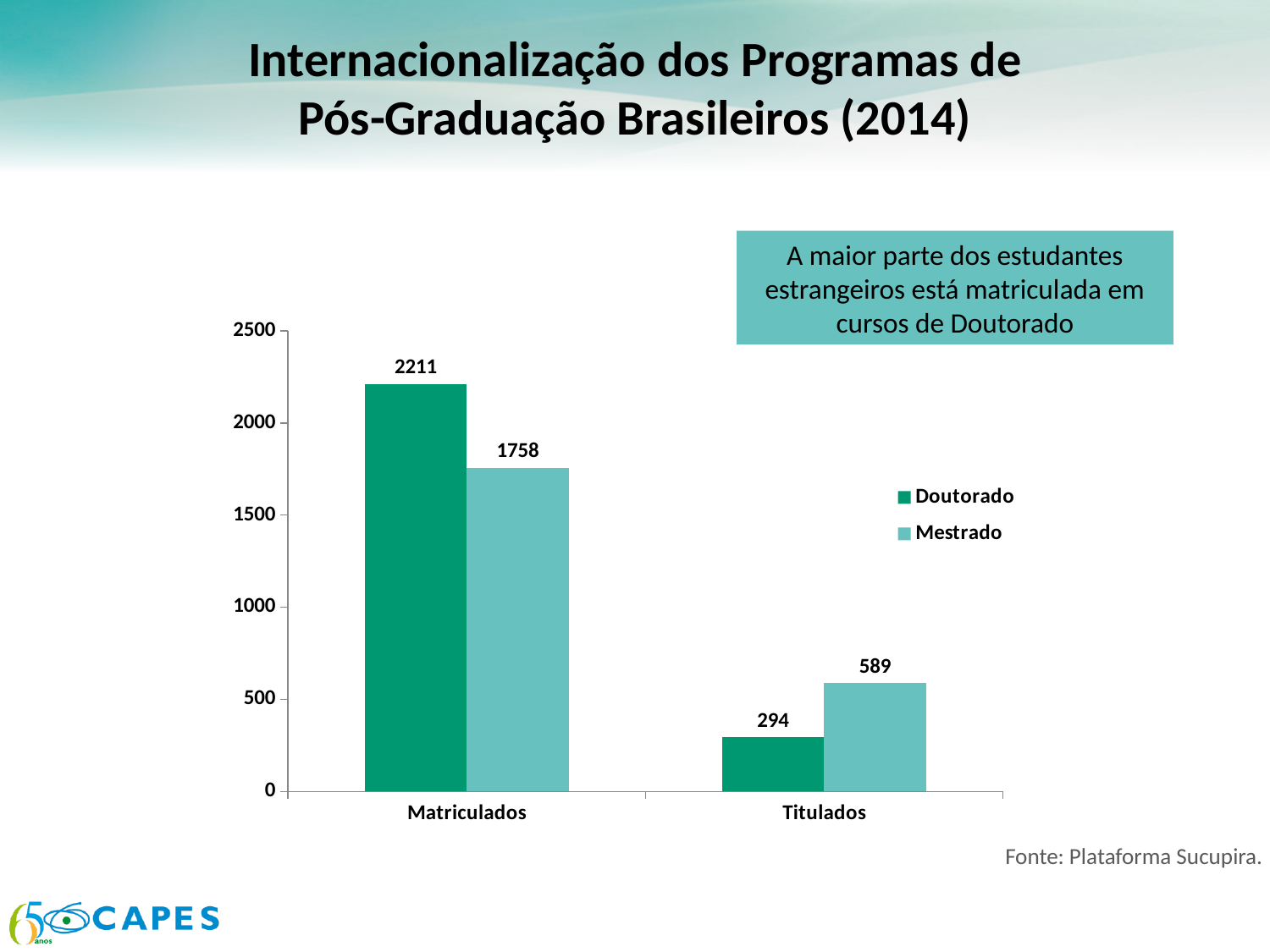
What kind of chart is shown on the slide? Bar chart What is the Mestrado value for Titulados? 589 What is the Mestrado value for Matriculados? 1758 Which category has the highest Doutorado value? Matriculados What is the difference between the Mestrado and Doutorado values for Titulados? 295 How many series does the legend list? 2 What is the Doutorado value for Matriculados? 2211 What is the Doutorado value for Titulados? 294 Which category has the lowest Mestrado value? Titulados For Titulados, which is larger: Doutorado or Mestrado? Mestrado How many categories are shown on the x axis? 2 What is the difference between the Doutorado and Mestrado values for Matriculados? 453